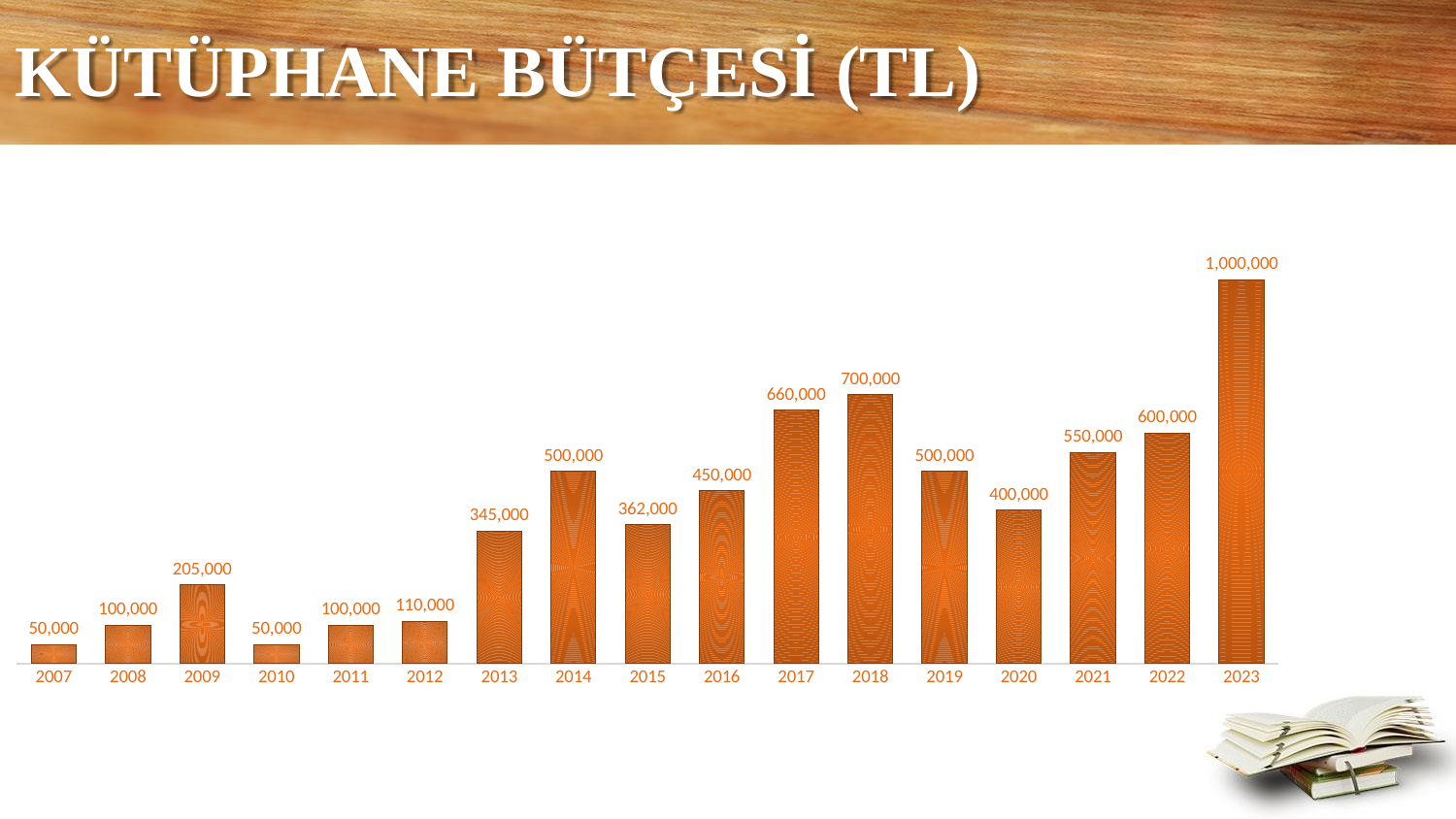
What is the difference between the values for 2023 and 2022? 400,000 What is the title of the chart on the slide? KÜTÜPHANE BÜTÇESİ (TL) Which year has the larger value, 2019 or 2020? 2019 Which year has the larger value, 2014 or 2016? 2014 What is the value shown for 2015? 362,000 What kind of chart is shown on the slide? Bar chart What is the library budget value shown for 2023? 1,000,000 What is the value shown for 2013? 345,000 Which years share the lowest value in the chart? 2007 and 2010 How many years are shown on the x axis of the chart? 17 What is the difference between the values for 2018 and 2017? 40,000 Which year has the highest value in the chart? 2023